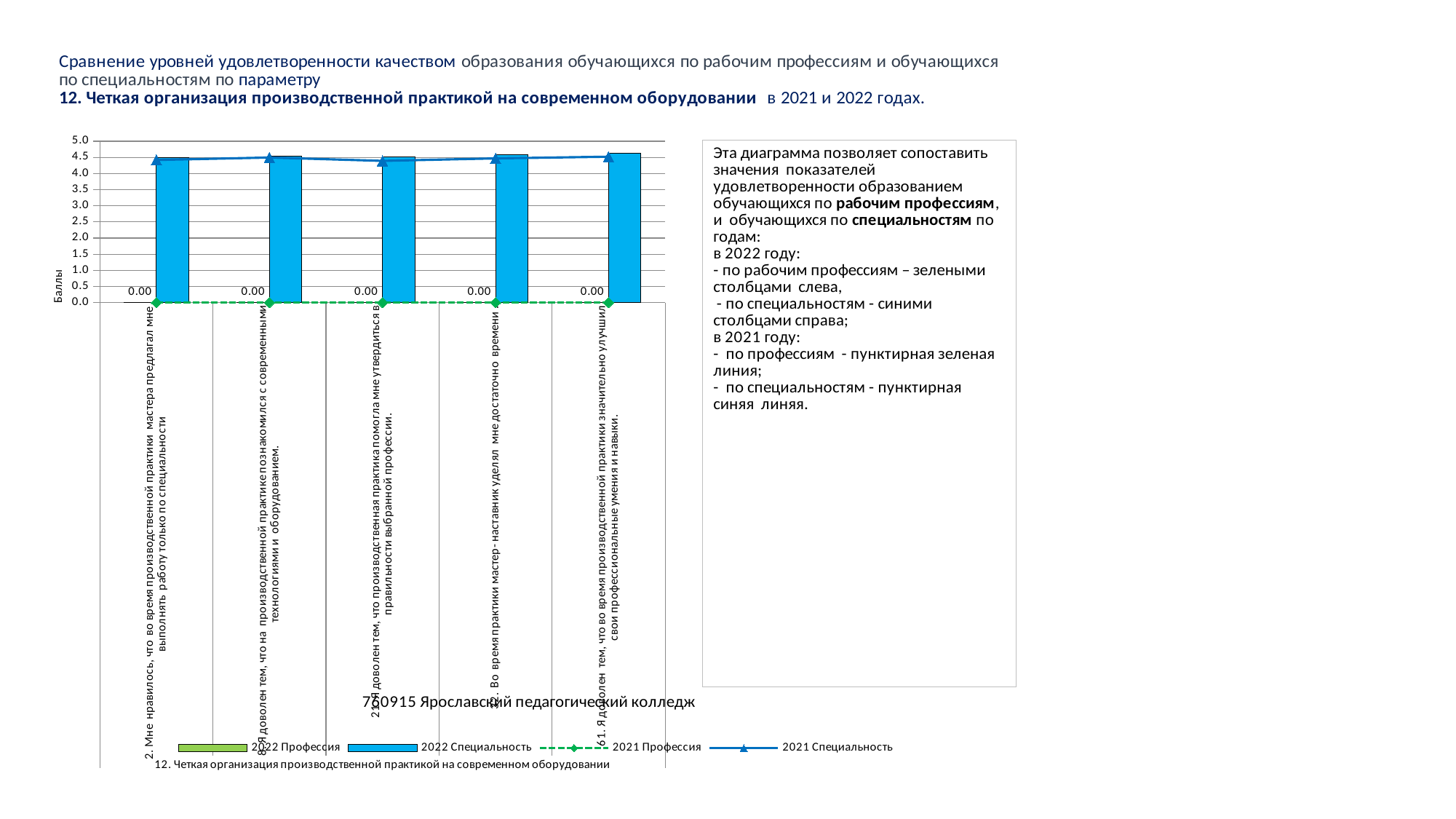
What is the value of the 2022 Профессия series for the first category ("2. Мне нравилось, что во время производственной практики мастера предлагал мне выполнять работу только по специальности")? 0.00 What is the title of the vertical axis of the chart? Баллы Is the 2022 Специальность value for the second category ("Я доволен тем, что на производственной практике познакомился с современными технологиями и оборудованием") greater or less than 4.0? greater How does the 2022 Профессия series change across the categories along the x axis? stays flat at 0.00 For the last category ("Я доволен тем, что во время производственной практики значительно улучшил свои профессиональные умения и навыки"), which is larger: the 2022 Специальность value or the 2022 Профессия value? 2022 Специальность How many categories are plotted along the x axis of the chart? 5 What colour are the bars for the 2022 Специальность series? blue How many series does the chart legend list? 4 What kind of chart is shown on the slide? bar chart with line series What is the value of the 2022 Профессия series for the category "Во время практики мастер-наставник уделял мне достаточно времени"? 0.00 Is the 2022 Специальность value for the fourth category ("Во время практики мастер-наставник уделял мне достаточно времени") greater or less than 3.0? greater Is the 2021 Специальность value for the first category greater or less than 4.0? greater